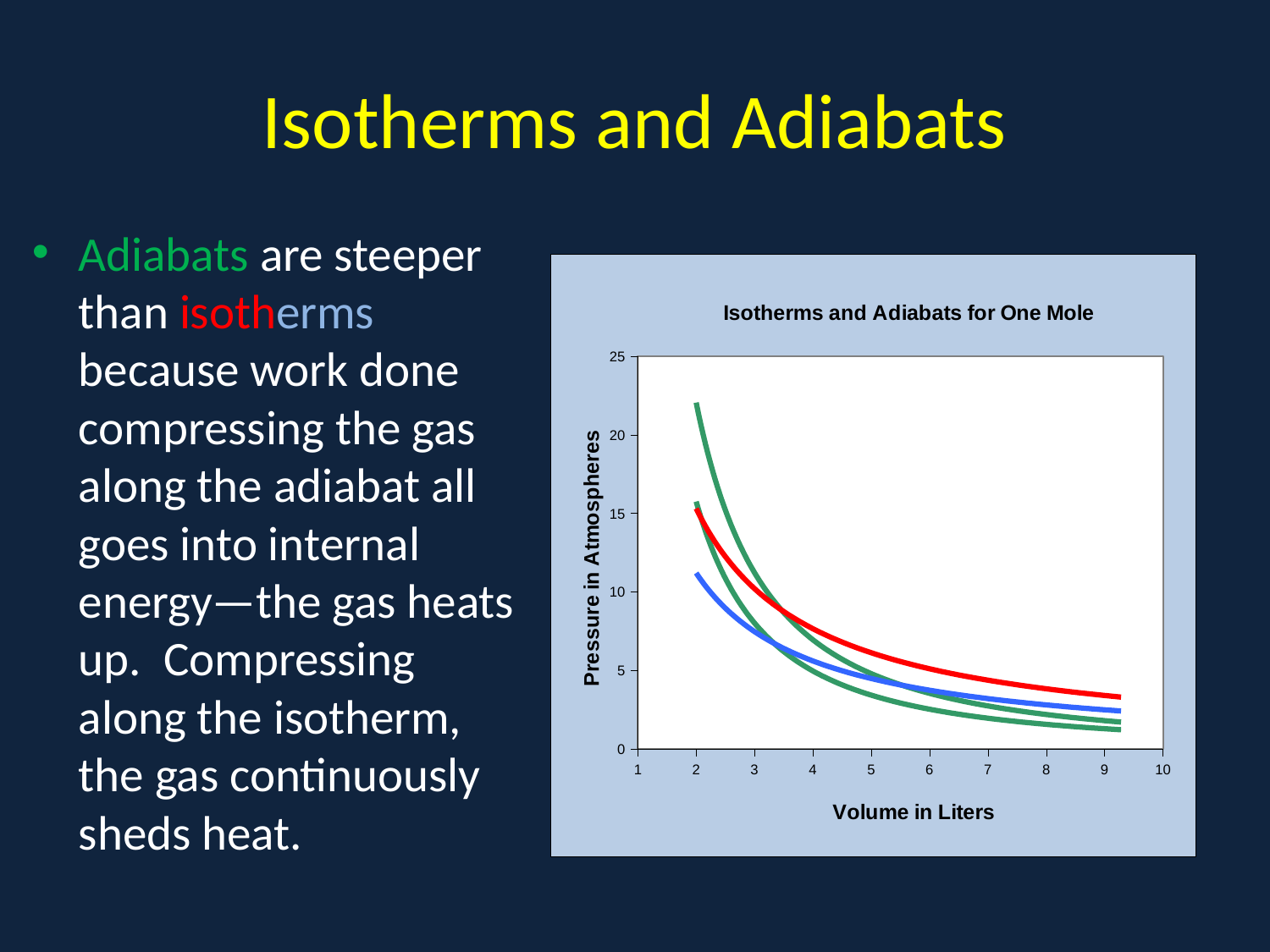
Do the curves on the chart rise or fall as volume increases along the x axis? fall At a volume of 9 liters, which curve has the higher pressure, the red curve or the blue curve? red curve What is the title of the chart? Isotherms and Adiabats for One Mole Is the pressure of the red curve at a volume of 9 liters greater or less than 5 atmospheres? less What is the highest value shown on the vertical axis of the chart? 25 Is the pressure of the highest green curve at a volume of 2 liters greater or less than 20 atmospheres? greater Is the pressure of the red curve at a volume of 4 liters greater or less than 5 atmospheres? greater At a volume of 2 liters, which curve has the lowest pressure? blue curve How many curves are plotted on the chart? 4 What is the label of the vertical axis of the chart? Pressure in Atmospheres What kind of chart is shown on the slide? line chart